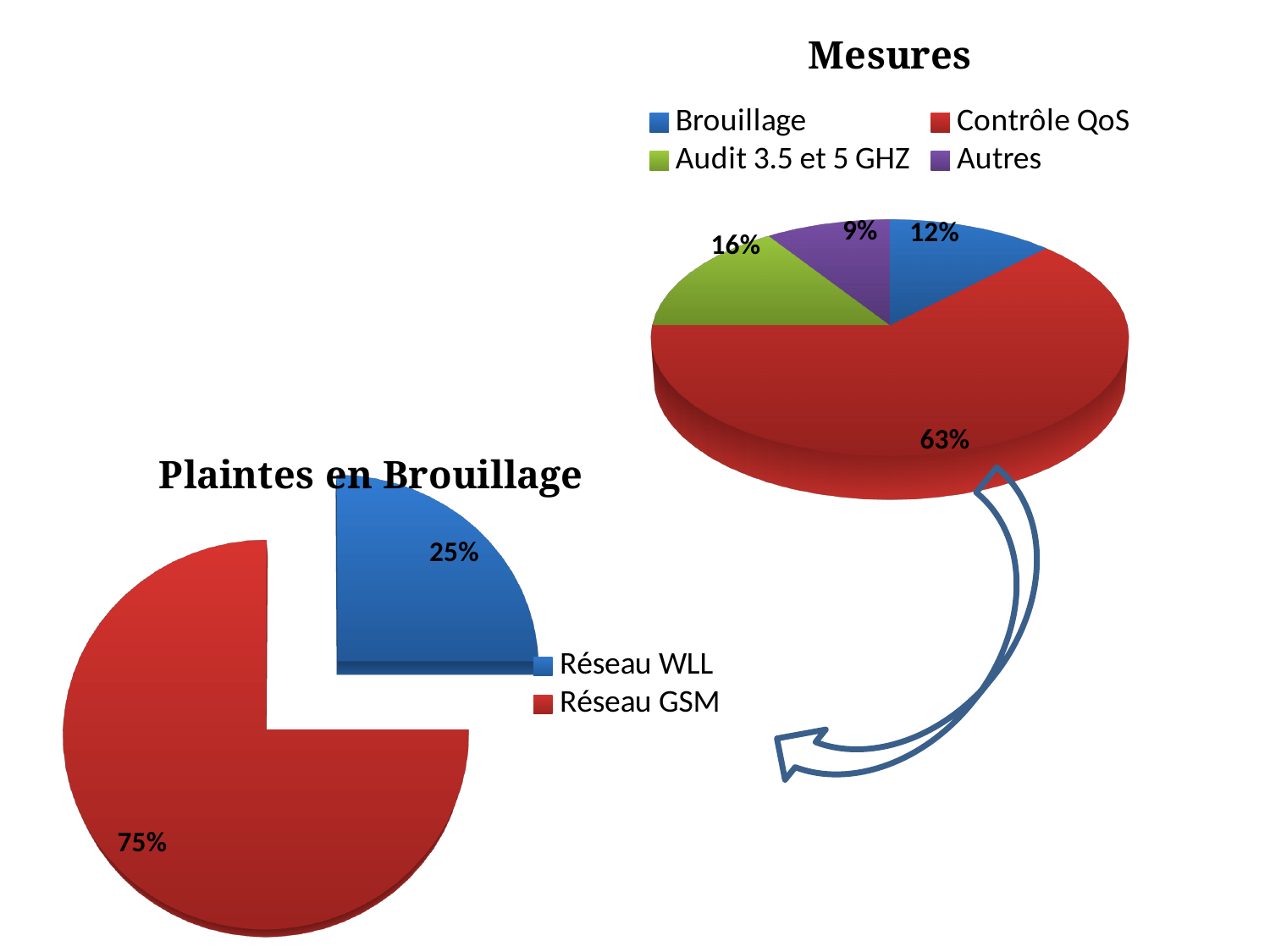
In the "Mesures" chart, what share does Audit 3.5 et 5 GHZ have? 16% In the "Mesures" chart, what share does Contrôle QoS have? 63% In the "Mesures" chart, how many categories does the legend list? 4 In the "Mesures" chart, which category has the smallest share? Autres What kind of chart is the "Plaintes en Brouillage" chart? Pie chart In the "Mesures" chart, what share does Autres have? 9% In the "Mesures" chart, what share does Brouillage have? 12% In the "Plaintes en Brouillage" chart, what share does Réseau WLL have? 25% In the "Mesures" chart, which category has the largest share? Contrôle QoS In the "Plaintes en Brouillage" chart, which is larger, Réseau WLL or Réseau GSM? Réseau GSM In the "Plaintes en Brouillage" chart, what share does Réseau GSM have? 75% In the "Mesures" chart, what is the difference between the shares of Contrôle QoS and Audit 3.5 et 5 GHZ? 47%